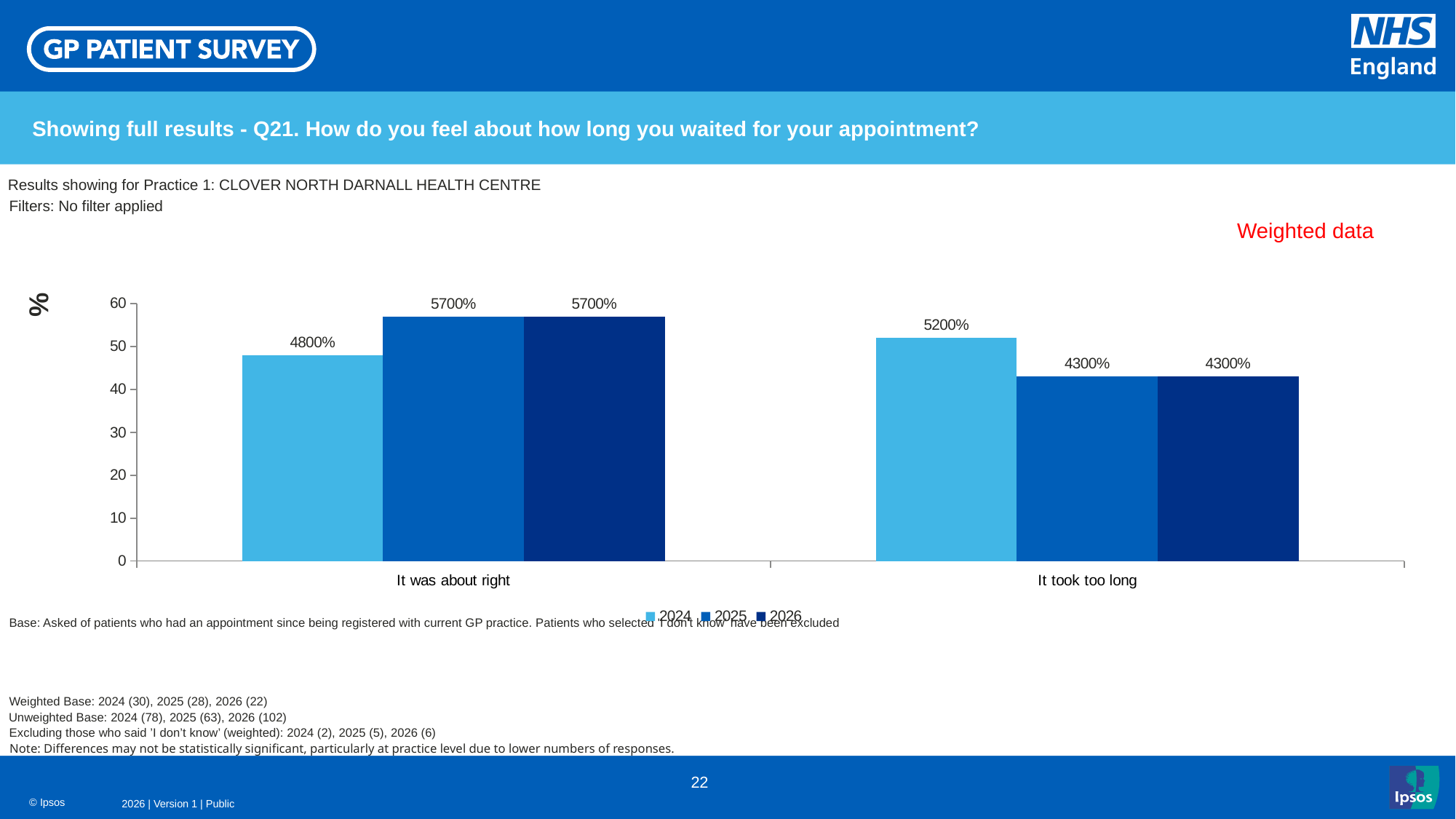
Is the 2025 bar for 'It was about right' greater or less than 50 on the axis? greater Is the 2024 bar for 'It was about right' larger or smaller than the 2024 bar for 'It took too long'? smaller Which year has the highest bar in the 'It took too long' category? 2024 Which years are listed in the chart legend? 2024, 2025, 2026 What is the data label for 2024 in the 'It took too long' category? 5200% What is the data label for 2026 in the 'It was about right' category? 5700% How many categories are shown on the x axis? 2 What is the data label for 2024 in the 'It was about right' category? 4800% What is the data label for 2025 in the 'It took too long' category? 4300% Which year has the lowest bar in the 'It was about right' category? 2024 How many series does the legend list? 3 What kind of chart is shown on the slide? bar chart